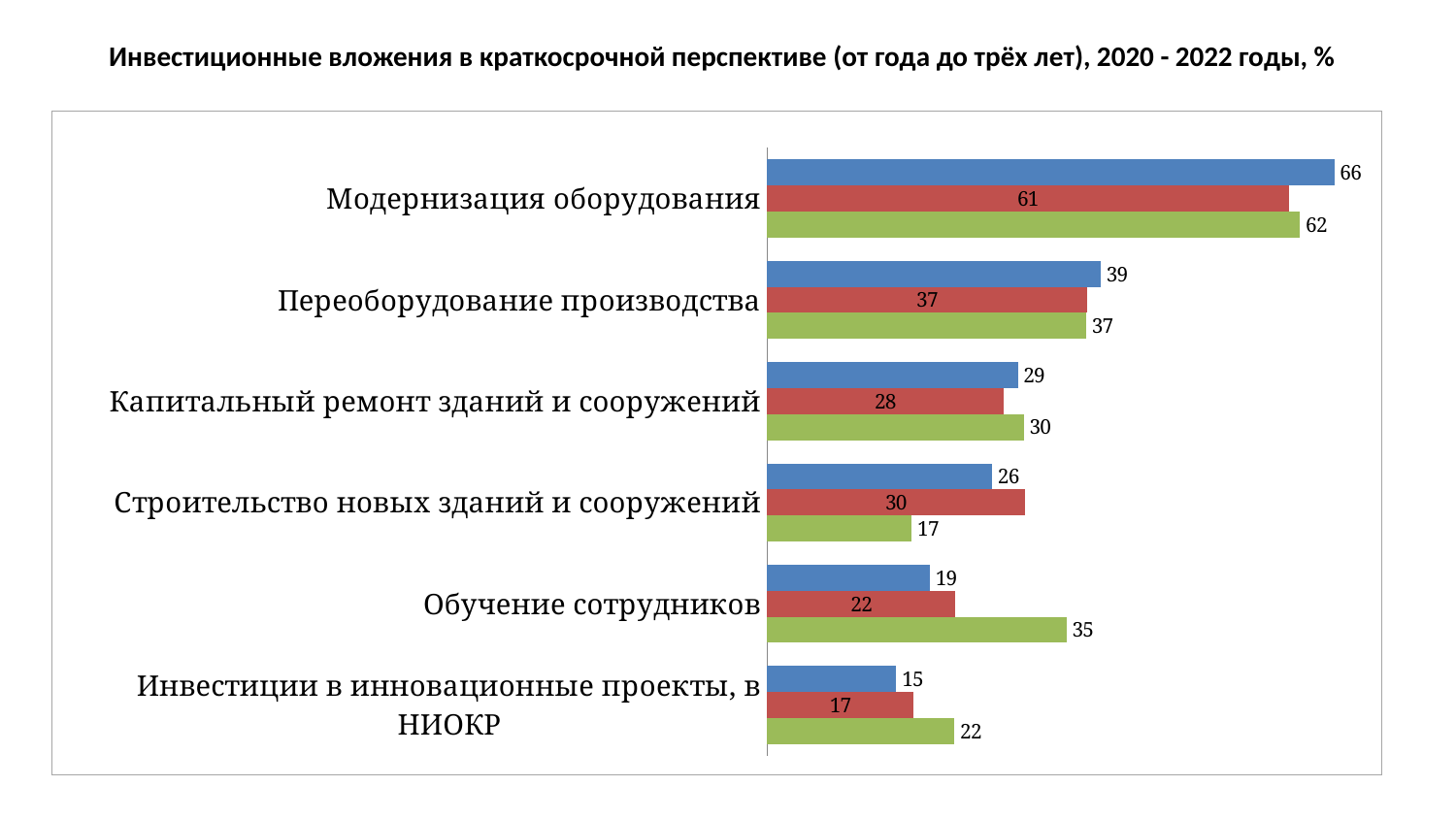
What is the value of the red bar for Строительство новых зданий и сооружений? 30 Which category has the lowest green bar value? Строительство новых зданий и сооружений What is the title of the chart? Инвестиционные вложения в краткосрочной перспективе (от года до трёх лет), 2020 - 2022 годы, % What kind of chart is shown on the slide? bar chart Which category has the highest blue bar value? Модернизация оборудования What is the difference between the green and blue bar values for Обучение сотрудников? 16 What is the difference between the blue and red bar values for Модернизация оборудования? 5 For Строительство новых зданий и сооружений, which is larger: the blue bar or the red bar? the red bar How many categories are shown on the chart? 6 What is the value of the blue bar for Модернизация оборудования? 66 What is the value of the green bar for Инвестиции в инновационные проекты, в НИОКР? 22 What is the value of the green bar for Обучение сотрудников? 35